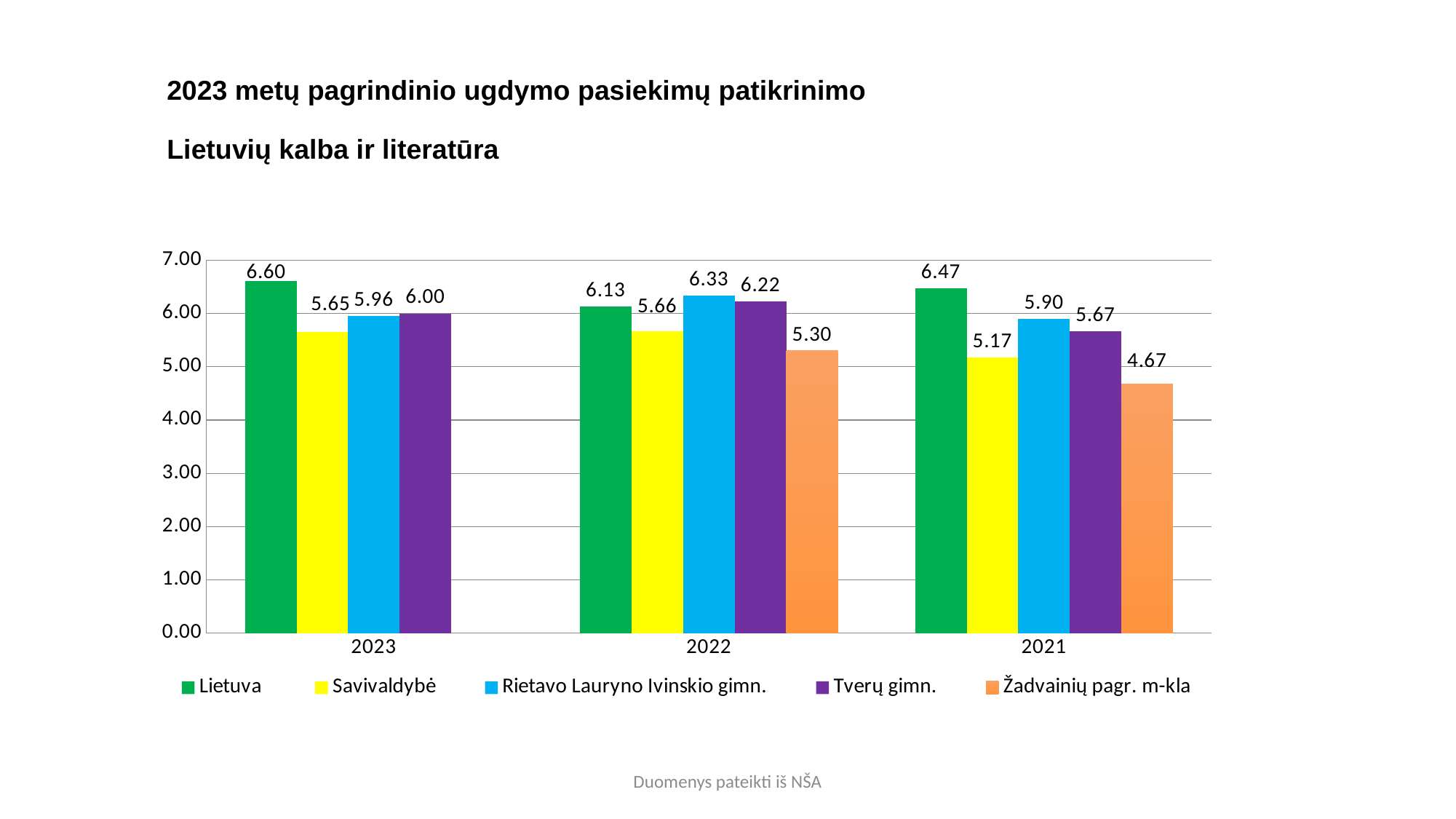
What is the difference between the Lietuva value and the Savivaldybė value in 2021? 1.30 How many year categories are shown on the x axis? 3 How many series does the legend list? 5 Which series is shown in yellow in the legend? Savivaldybė What is the value for Rietavo Lauryno Ivinskio gimn. in 2022? 6.33 What kind of chart is shown on the slide? Bar chart What is the value for Lietuva in 2023? 6.60 Which series has the lowest value in 2022? Žadvainių pagr. m-kla What is the value for Žadvainių pagr. m-kla in 2021? 4.67 Which is larger in 2022: the value for Rietavo Lauryno Ivinskio gimn. or the value for Tverų gimn.? Rietavo Lauryno Ivinskio gimn. What is the value for Tverų gimn. in 2023? 6.00 Which series has the highest value in 2021? Lietuva